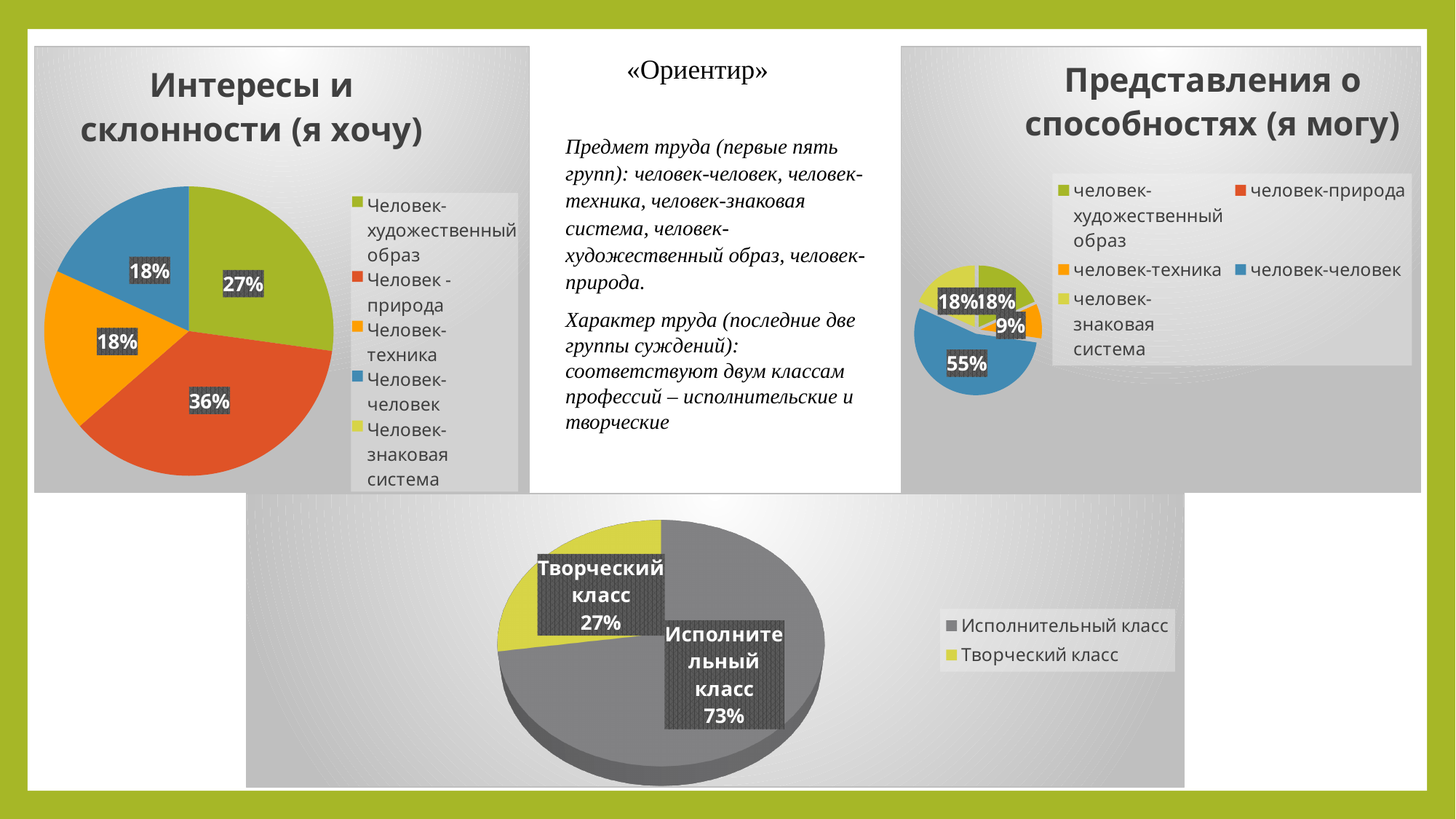
In the chart titled «Интересы и склонности (я хочу)», how many entries does the legend list? 5 In the bottom pie chart, what percentage is shown for Творческий класс? 27% What type of chart is the one titled «Интересы и склонности (я хочу)»? pie chart In the chart titled «Интересы и склонности (я хочу)», which category has the largest slice? Человек-природа In the chart titled «Интересы и склонности (я хочу)», what percentage is shown for Человек-художественный образ? 27% In the chart titled «Представления о способностях (я могу)», what percentage is shown for человек-человек? 55% In the chart titled «Представления о способностях (я могу)», which category has the largest slice? человек-человек In the chart titled «Интересы и склонности (я хочу)», what percentage is shown for Человек-природа? 36% In the bottom pie chart, what percentage is shown for Исполнительный класс? 73% In the chart titled «Представления о способностях (я могу)», what percentage is shown for человек-техника? 9% In the bottom pie chart, which is larger: Исполнительный класс or Творческий класс? Исполнительный класс In the chart titled «Интересы и склонности (я хочу)», what is the difference between the Человек-природа and Человек-художественный образ slices? 9%